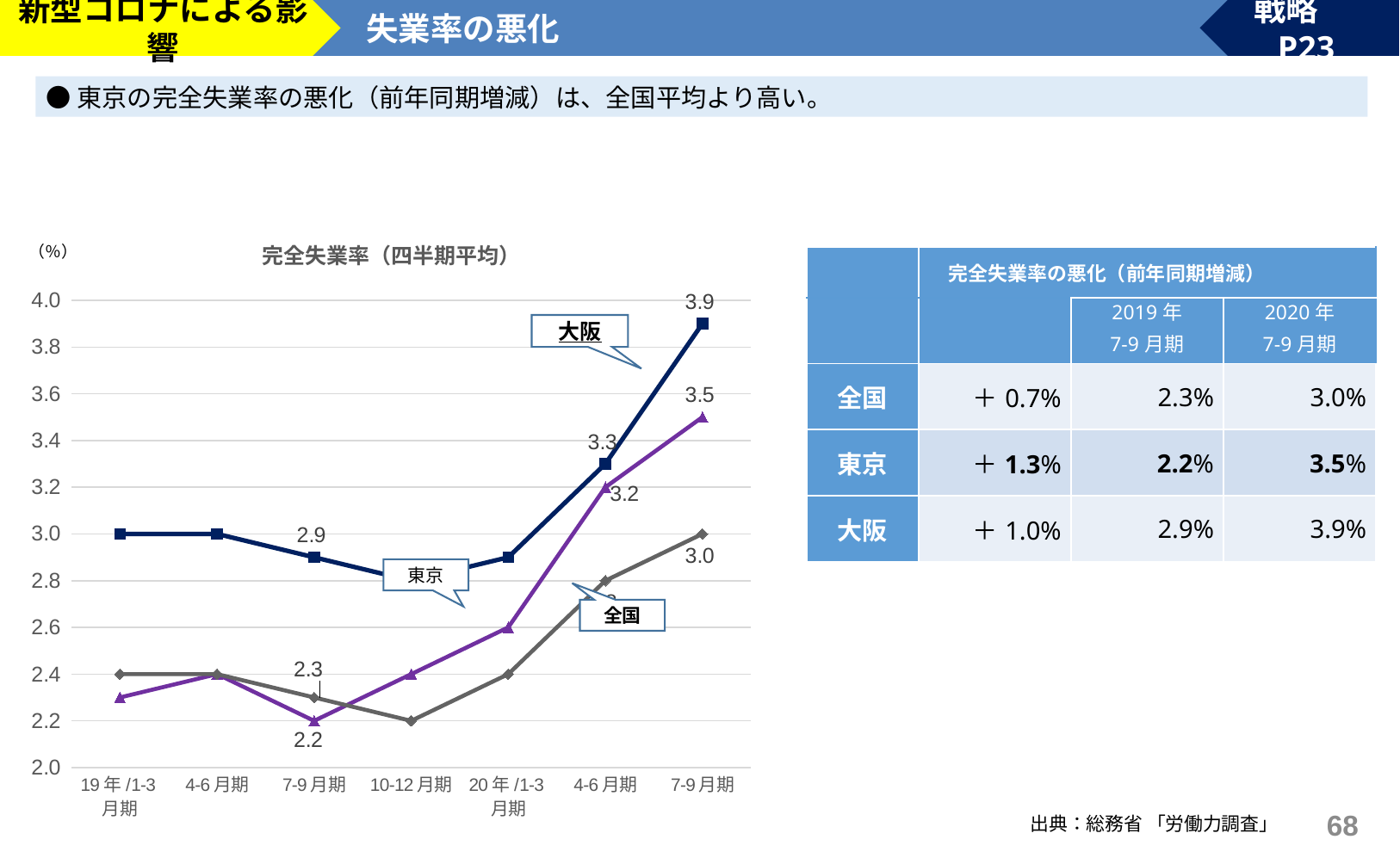
How many series are plotted in the chart? 3 What kind of chart is shown on the slide? line chart Which series has the highest value in 20年7-9月期? 大阪 Does the 大阪 line rise or fall from 20年/1-3月期 to 20年7-9月期? rise Is the value for 全国 in 10-12月期 greater or less than 2.4? less How many quarters are plotted along the x axis of the chart? 7 What is the difference between 大阪 and 東京 in 20年7-9月期? 0.4 What is the value for 全国 in 20年7-9月期? 3.0 What is the value for 東京 in 20年7-9月期? 3.5 What is the value for 東京 in 19年7-9月期? 2.2 What is the title of the chart? 完全失業率（四半期平均） What is the value for 大阪 in 20年7-9月期? 3.9